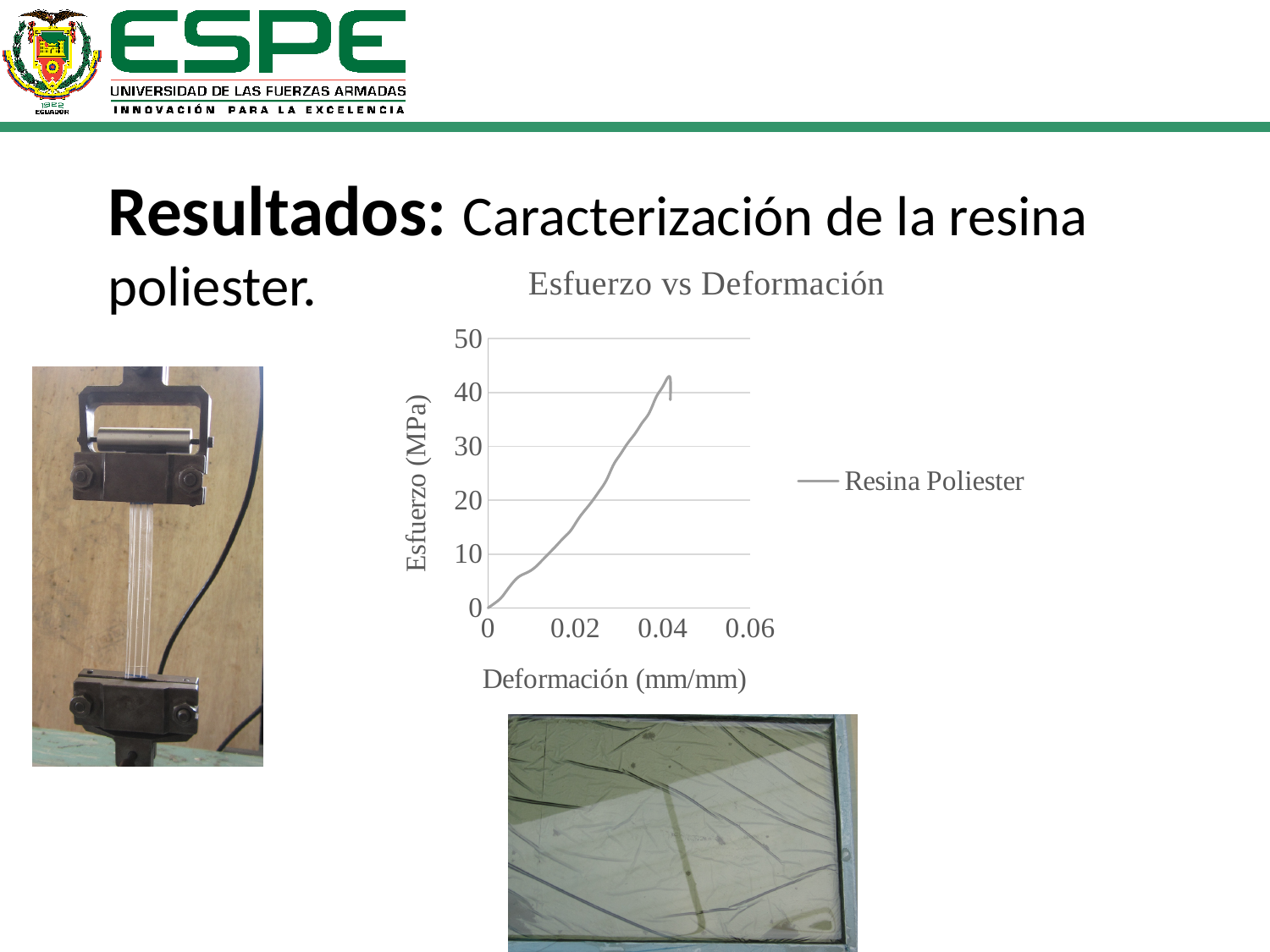
What kind of chart is shown on the slide? line chart Is the maximum stress reached by the Resina Poliester curve greater or less than 40 MPa? greater Is the stress value at a deformation of 0.02 mm/mm greater or less than 20 MPa? less Is the maximum stress reached by the Resina Poliester curve greater or less than 50 MPa? less How many series does the chart legend list? 1 What is the highest value shown on the y axis (Esfuerzo) of the chart? 50 What is the name of the series shown in the chart legend? Resina Poliester What is the title of the chart? Esfuerzo vs Deformación Does the stress (Esfuerzo) generally rise or fall as the deformation increases from 0 to 0.04 mm/mm? rise